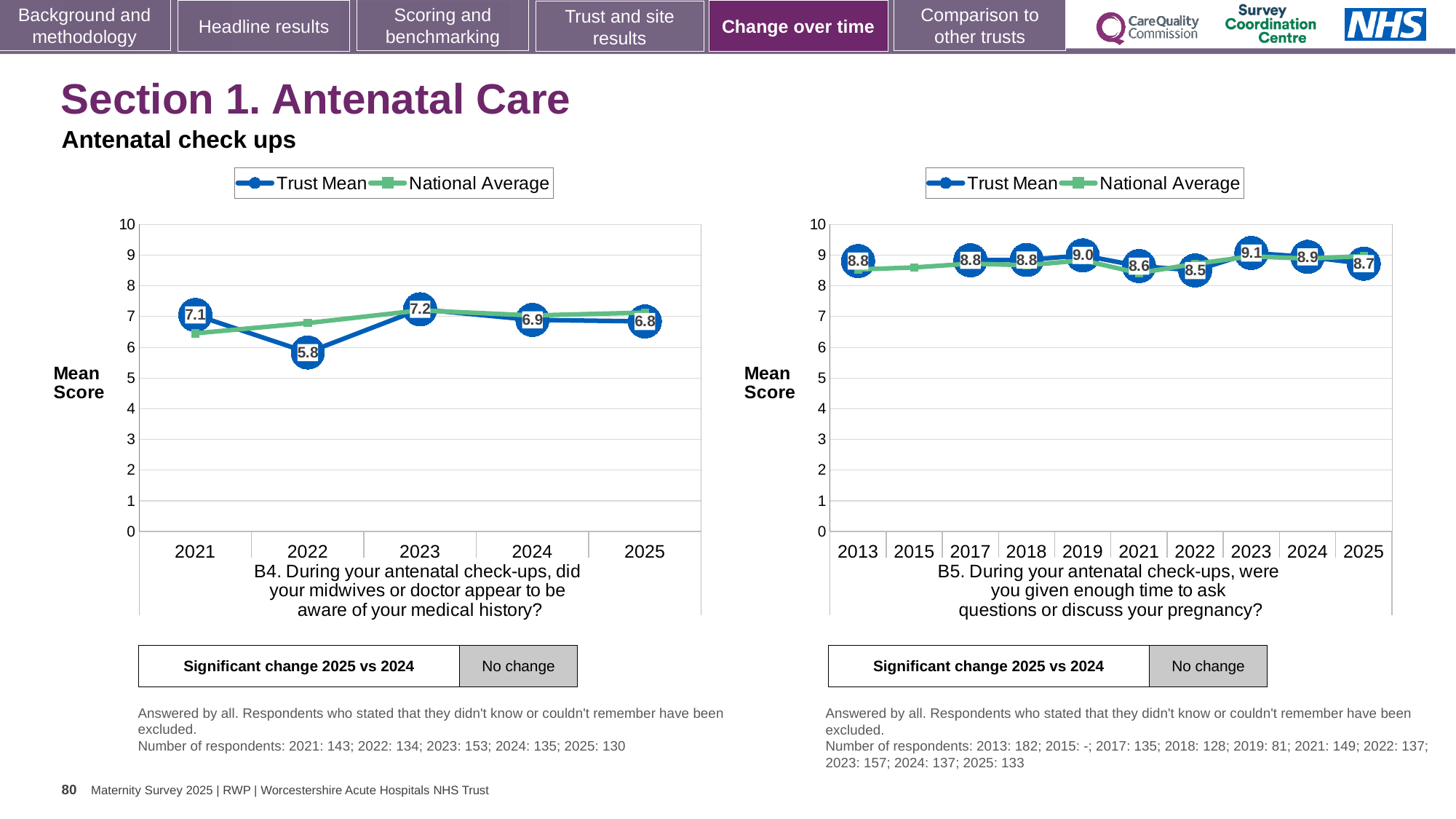
In the B5 chart on the right, which year has the highest Trust Mean? 2023 In the B4 chart on the left, what is the Trust Mean for 2022? 5.8 In the B4 chart on the left, what is the Trust Mean for 2025? 6.8 In the B5 chart on the right, how many series does the legend list? 2 In the B5 chart on the right, what is the Trust Mean for 2019? 9.0 In the B4 chart on the left, how many years are shown on the x axis? 5 In the B5 chart on the right, which year has the lowest Trust Mean? 2022 In the B4 chart on the left, which year has the highest Trust Mean? 2023 In the B4 chart on the left, which year has the lowest Trust Mean? 2022 In the B4 chart on the left, what is the difference between the Trust Mean for 2023 and the Trust Mean for 2022? 1.4 What kind of chart is the B4 chart on the left? line chart In the B5 chart on the right, is the Trust Mean for 2022 larger or smaller than the Trust Mean for 2023? smaller